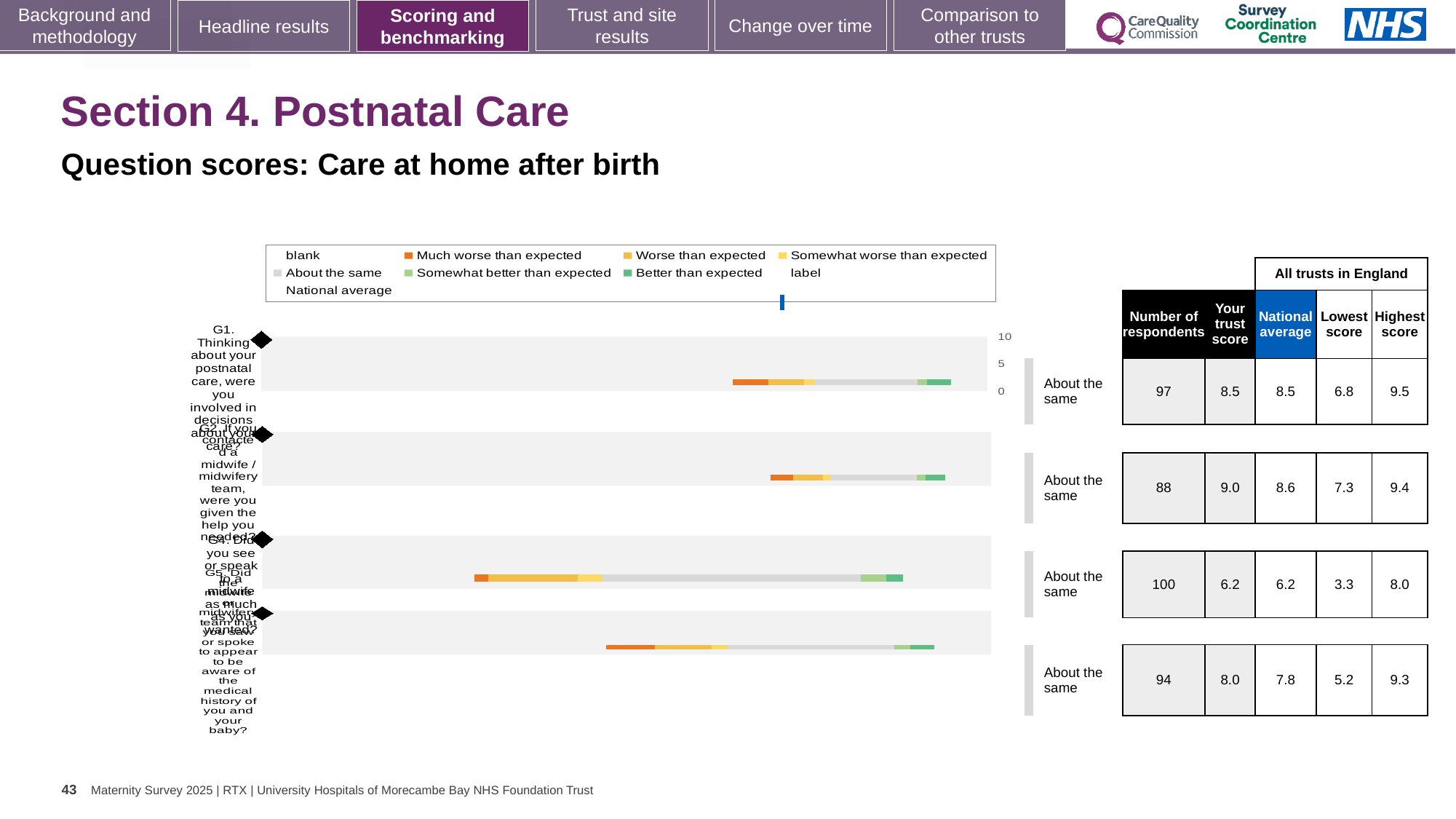
In the table, what is the trust score for the first question (G1)? 8.5 What is the difference between the trust score and the national average for the second question (G2)? 0.4 Which question row has the lowest trust score in the table? the third row (6.2) How many question bars are plotted in the chart? 4 What benchmark rating is given to every question in this chart? About the same In the table, what is the number of respondents for the first question (G1)? 97 In the table, what is the highest score for the fourth question row? 9.3 What is the maximum value shown on the chart's score axis? 10 Which legend entry is shown in dark orange? Much worse than expected In the table, what is the lowest score for the third question row? 3.3 What kind of chart is shown on the slide? bar chart In the table, what is the national average for the second question (G2)? 8.6